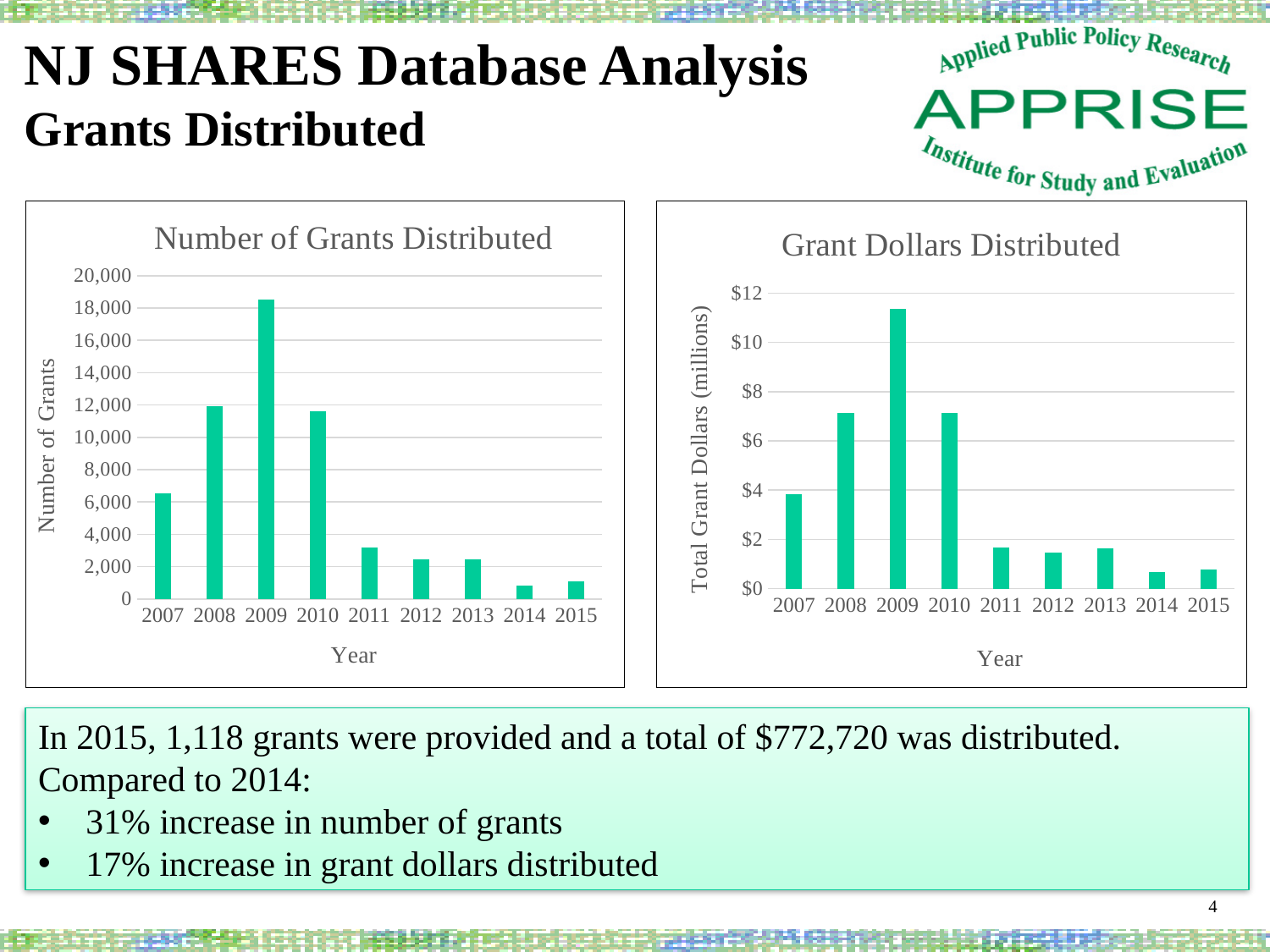
In the 'Number of Grants Distributed' chart, is the value for 2014 greater or less than 2,000? less In the 'Grant Dollars Distributed' chart, which year has more grant dollars, 2008 or 2013? 2008 In the 'Number of Grants Distributed' chart, is the value for 2009 greater or less than 16,000? greater In the 'Grant Dollars Distributed' chart, is the value for 2011 greater or less than $2? less In the 'Grant Dollars Distributed' chart, which year has the highest total grant dollars? 2009 How many years are shown on the x axis of the 'Number of Grants Distributed' chart? 9 In the 'Grant Dollars Distributed' chart, do the values rise or fall from 2009 to 2014? Fall In the 'Number of Grants Distributed' chart, which year has the highest number of grants? 2009 What kind of chart is 'Grant Dollars Distributed'? Bar chart In the 'Number of Grants Distributed' chart, which year has the lowest number of grants? 2014 In the 'Number of Grants Distributed' chart, which year has more grants, 2007 or 2011? 2007